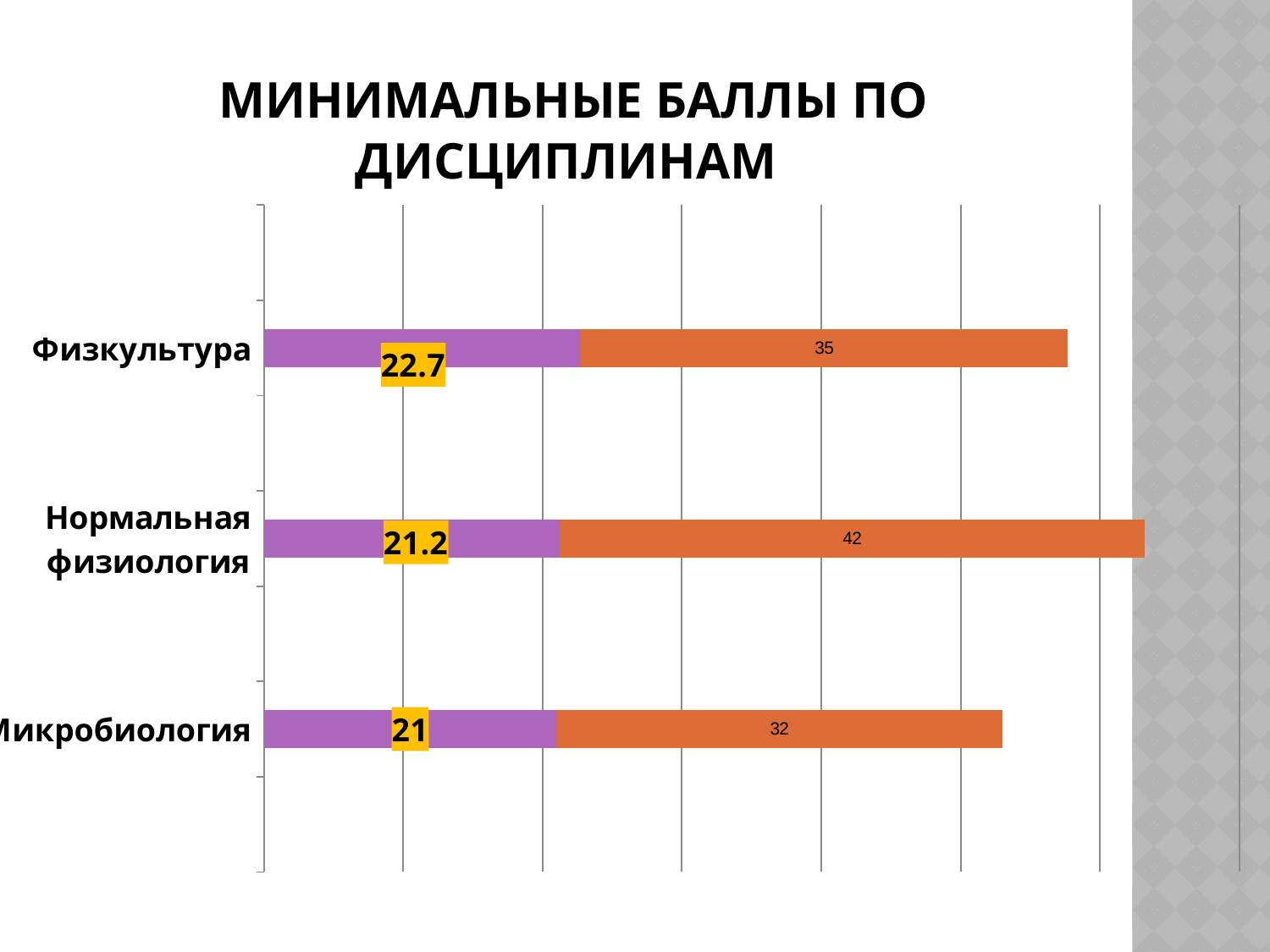
What is the value of the purple segment for Микробиология? 21 What is the value of the orange segment for Нормальная физиология? 42 Which is larger: the purple segment value for Физкультура or for Нормальная физиология? Физкультура What is the value of the orange segment for Микробиология? 32 What is the title of the chart? МИНИМАЛЬНЫЕ БАЛЛЫ ПО ДИСЦИПЛИНАМ What is the difference between the orange segment values for Нормальная физиология and Микробиология? 10 Which discipline has the highest value in the orange segment? Нормальная физиология How many disciplines are shown in the chart? 3 What is the total of the stacked bar for Физкультура? 57.7 Which discipline has the lowest value in the orange segment? Микробиология What kind of chart is shown on the slide? Stacked bar chart What is the value of the purple segment for Физкультура? 22.7